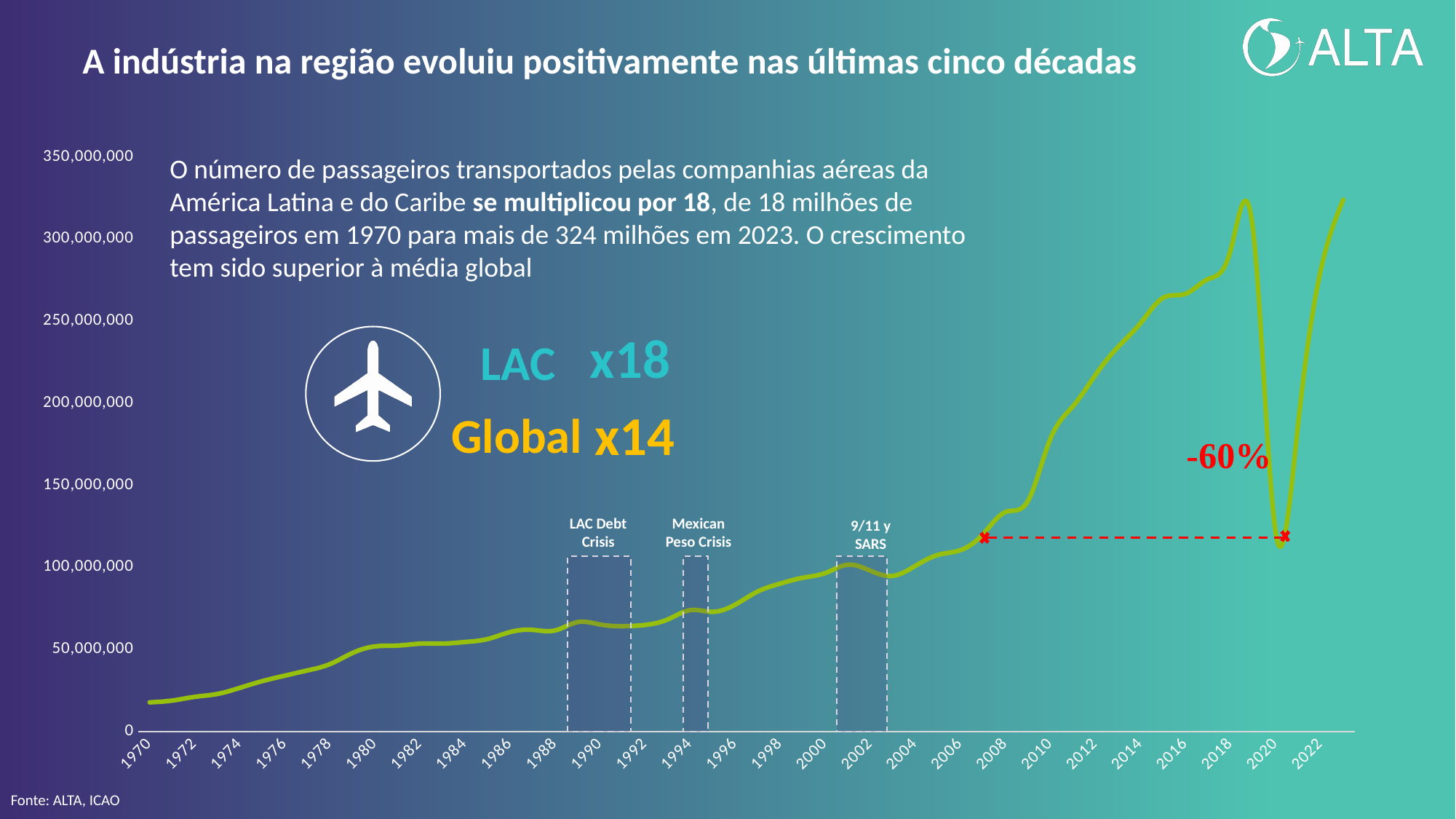
Which is larger, the value for 2018 or the value for 2020? 2018 What kind of chart is shown on the slide? line chart How many crisis periods are highlighted with dashed boxes on the chart? 3 Which year on the x axis has the lowest value on the chart? 1970 Overall, do the values on the chart rise or fall from 1970 to 2022? rise Is the value for 2010 greater or less than 150,000,000? greater What is the highest value shown on the y axis of the chart? 350,000,000 Is the value for 1990 greater or less than 50,000,000? greater Is the value for 2020 greater or less than 150,000,000? less What percentage drop is annotated in red on the chart around 2020? -60%